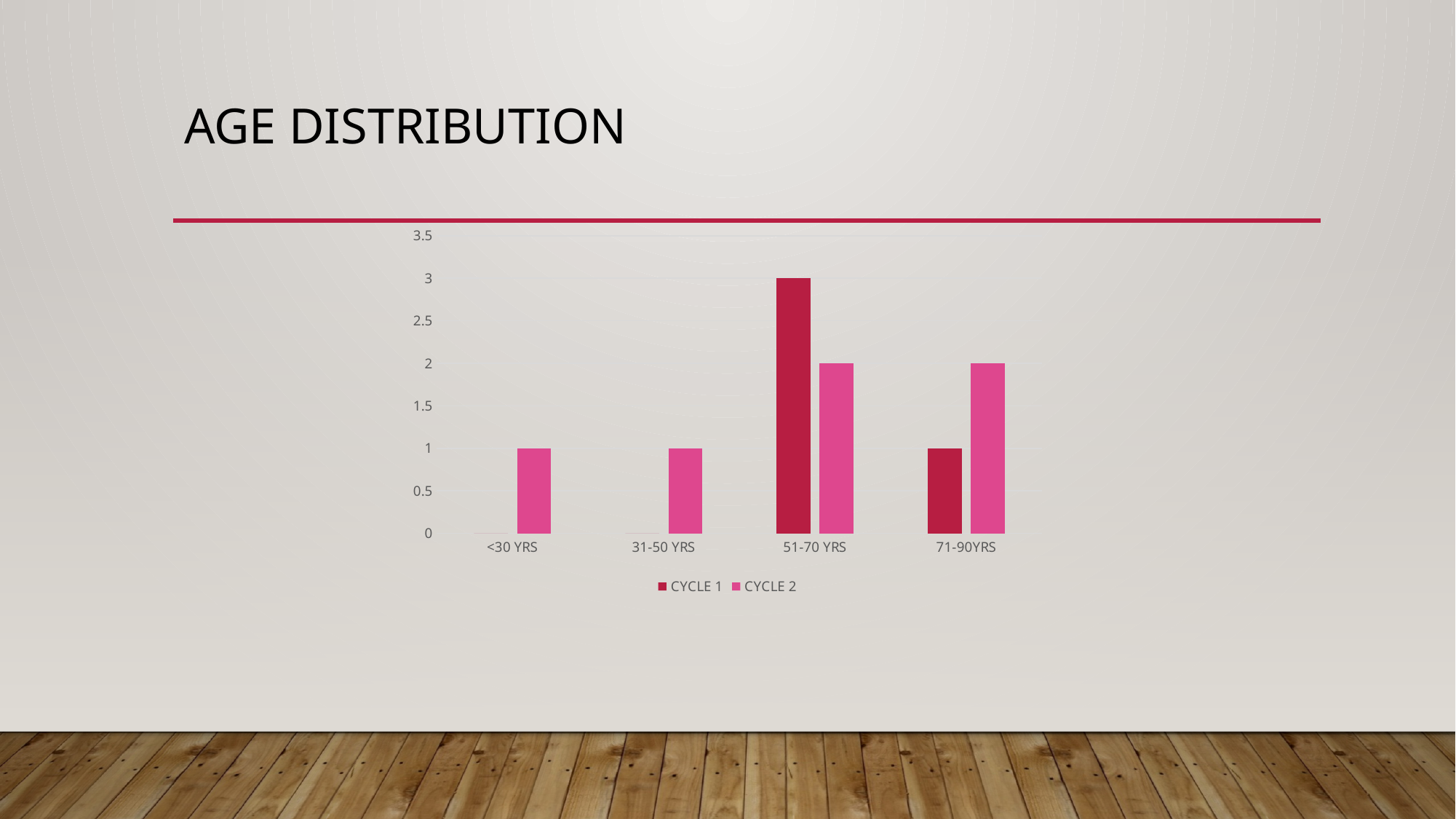
What is the Cycle 2 value for 71-90YRS? 2 What kind of chart is shown on the slide? Bar chart What is the Cycle 1 value for 71-90YRS? 1 Which age category has the highest Cycle 2 value? 51-70 YRS and 71-90YRS (tied at 2) What is the difference between the Cycle 1 and Cycle 2 values for 51-70 YRS? 1 How many series does the legend list? 2 What is the Cycle 2 value for <30 YRS? 1 For 71-90YRS, which is larger, Cycle 1 or Cycle 2? Cycle 2 What is the title of the chart slide? AGE DISTRIBUTION What is the Cycle 1 value for 51-70 YRS? 3 Which age category has the highest Cycle 1 value? 51-70 YRS How many age categories are shown on the x axis? 4